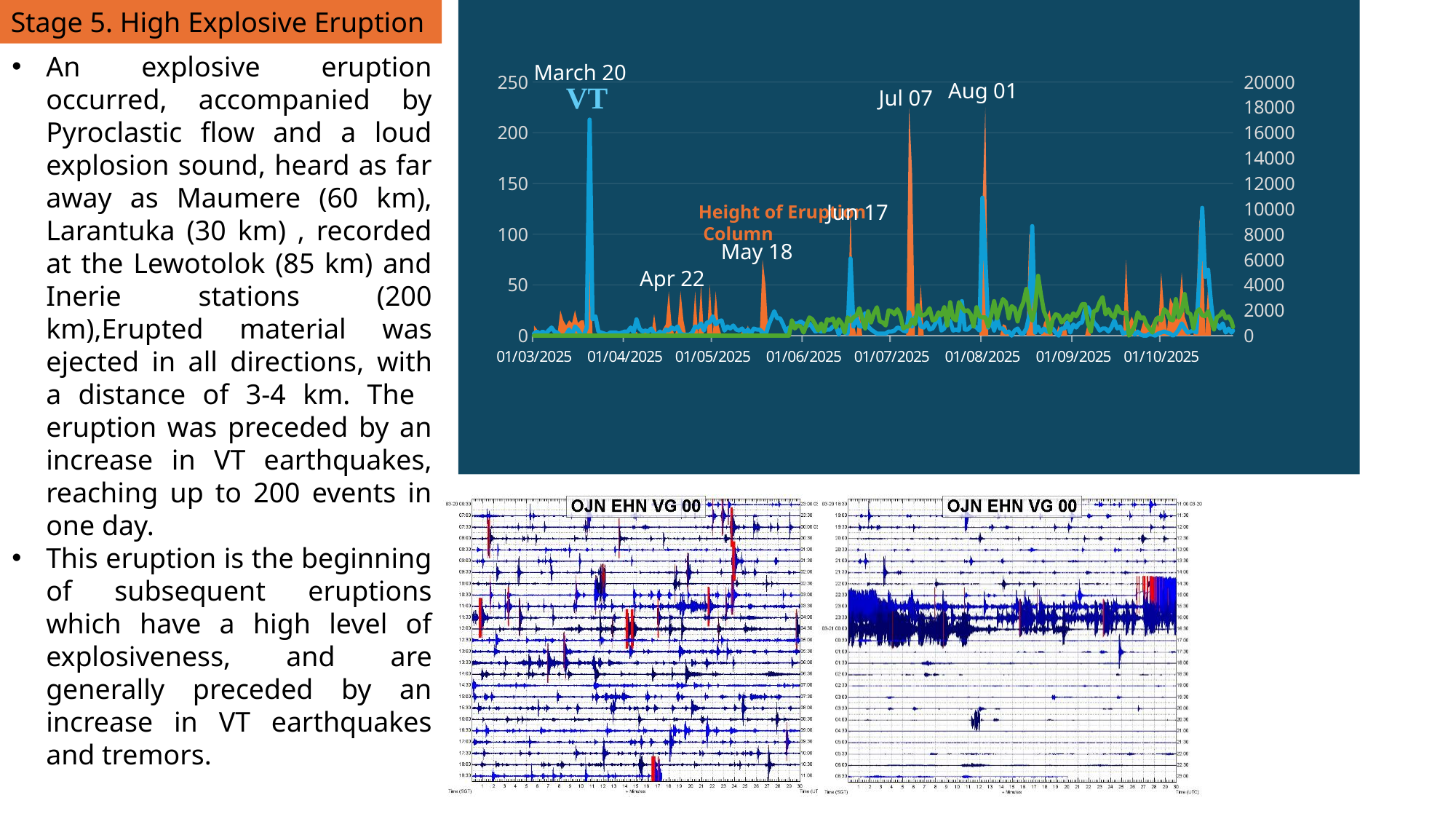
What is the first date shown on the x axis of the top-right chart? 01/03/2025 How many dated event annotations (such as March 20, Apr 22) are shown on the top-right chart? 6 In the top-right chart, is the VT value around Apr 22 greater or less than 50 on the left axis? less In the top-right chart, is the VT peak on March 20 greater or less than 150 on the left axis? greater In the top-right chart, which series does the blue line represent? VT In the top-right chart, which VT peak is larger: March 20 or Jun 17? March 20 What is the last date shown on the x axis of the top-right chart? 01/10/2025 In the top-right chart, which series does the orange line represent? Height of Eruption Column What kind of chart is the chart at the top right of the slide? combination area and line chart In the top-right chart, is the VT peak on Jun 17 greater or less than 150 on the left axis? less In the top-right chart, on which annotated date does the VT series reach its highest peak? March 20 How many date ticks are labelled on the x axis of the top-right chart? 8